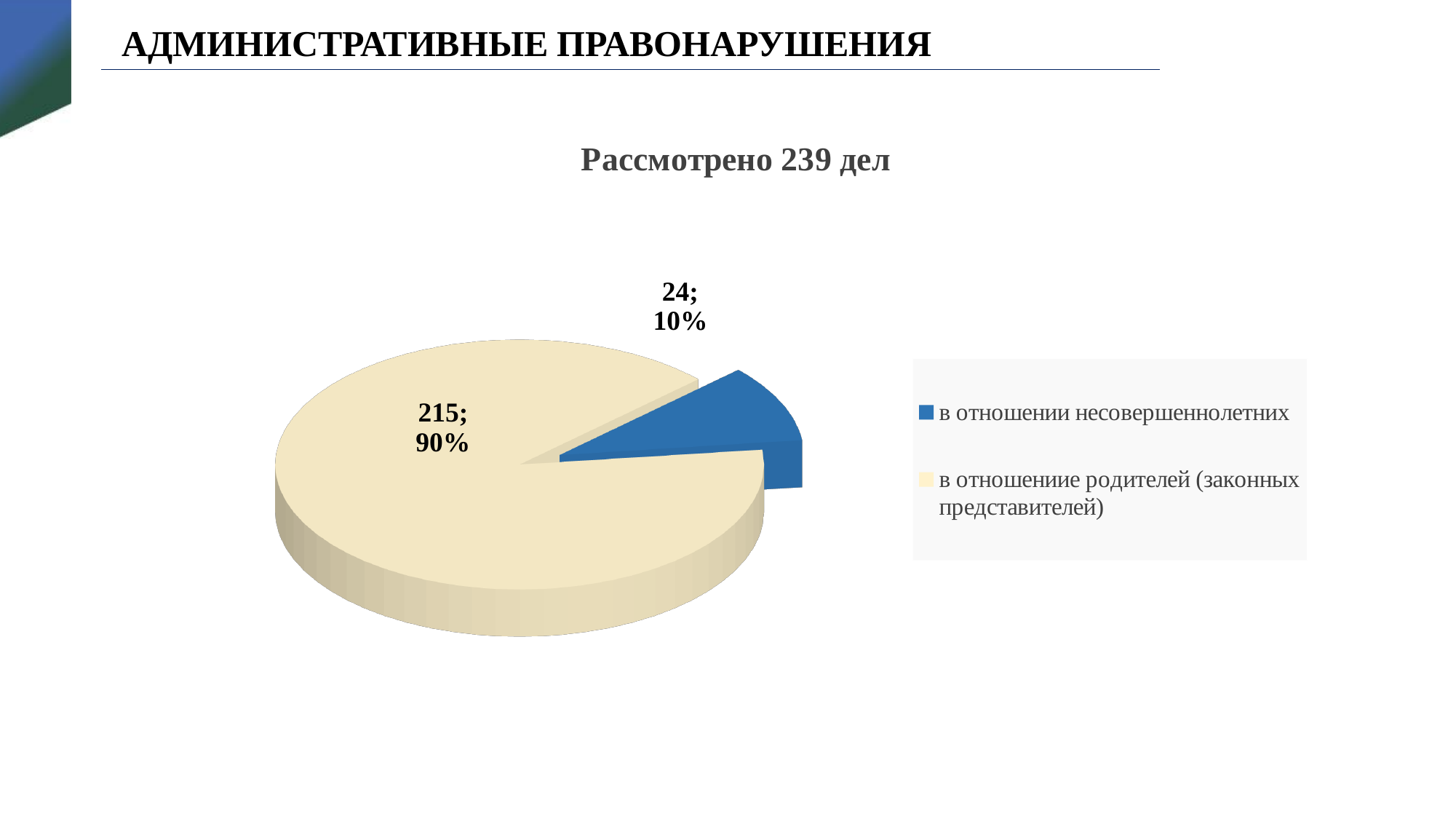
What colour is the slice for 'в отношении несовершеннолетних'? blue What is the value for 'в отношениие родителей (законных представителей)'? 215 How many entries does the legend list? 2 What share of the pie does 'в отношениие родителей (законных представителей)' represent? 90% What is the title of the chart? Рассмотрено 239 дел What kind of chart is shown on the slide? pie chart Which category has the smallest slice? в отношении несовершеннолетних How many slices does the pie chart have? 2 What is the difference between the values for 'в отношениие родителей (законных представителей)' and 'в отношении несовершеннолетних'? 191 What share of the pie does 'в отношении несовершеннолетних' represent? 10% Which category has the largest slice? в отношениие родителей (законных представителей) What is the value for 'в отношении несовершеннолетних'? 24